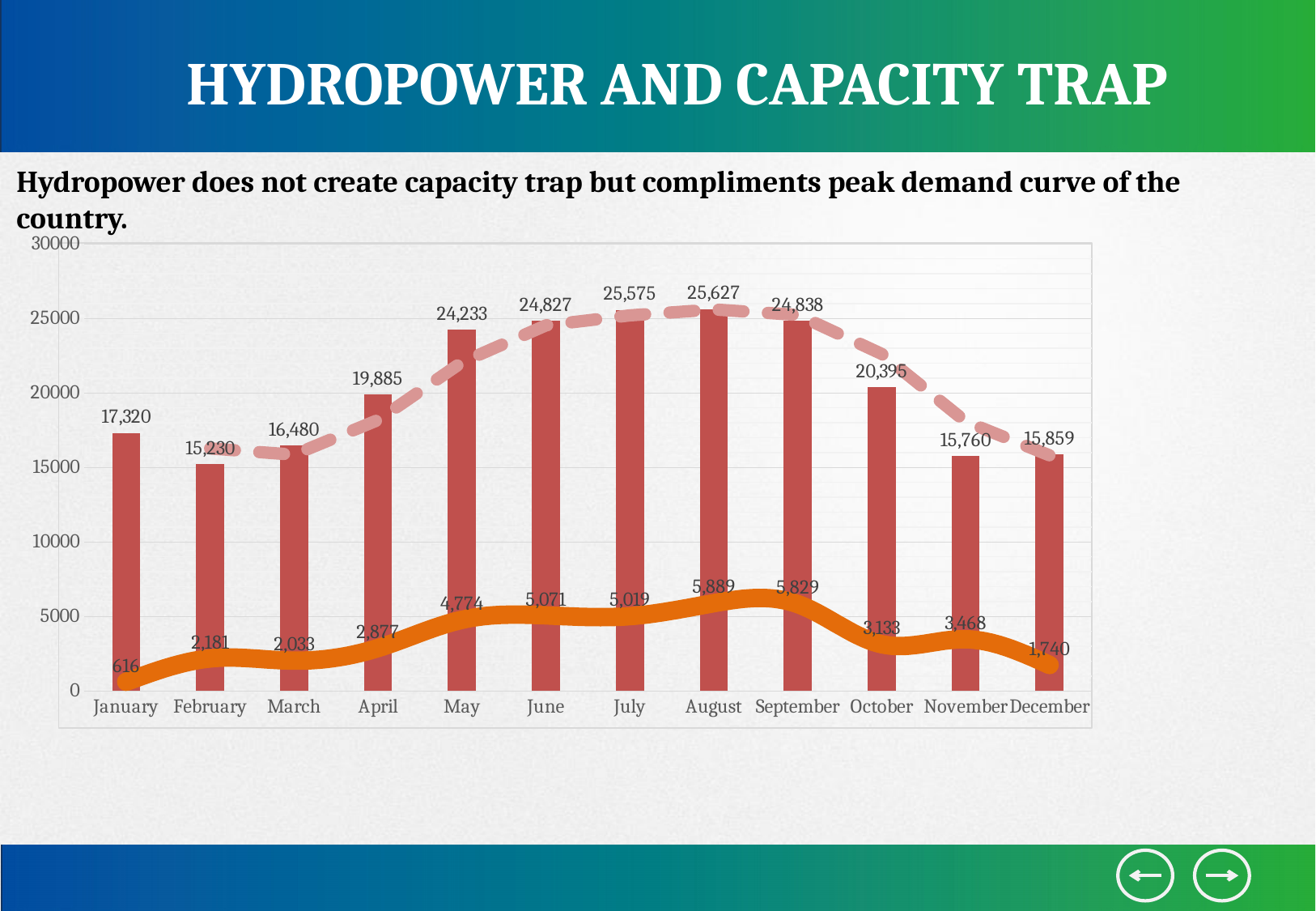
What is the difference between the bar values for August and January? 8,307 What is the bar value for October? 20,395 Do the bar values rise or fall from January to August? Rise What kind of chart is shown on the slide? Bar chart with a line Which month has the lowest value on the orange line? January Which has the larger bar value, April or November? April Which month has the highest bar value? August How many months are shown on the x axis? 12 What is the bar value for May? 24,233 What is the value of the orange line for September? 5,829 What is the difference between the orange line values for September and October? 2,696 Which month has the lowest bar value? February